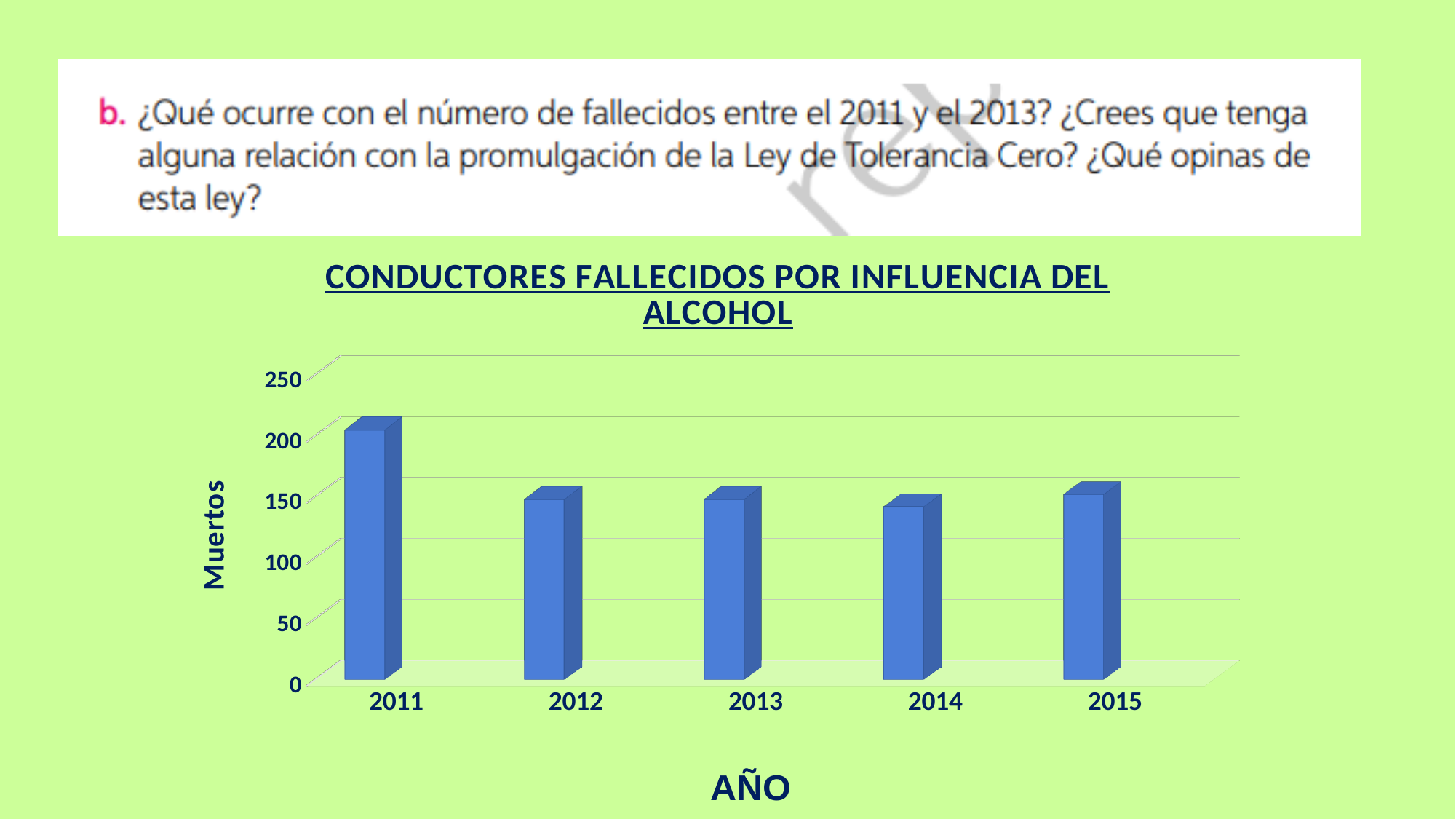
Is the value for 2011 greater or less than 150? greater Is the value for 2014 greater or less than 200? less What is the label of the vertical axis of the chart? Muertos Which year has the highest number of Muertos in the chart? 2011 Does the number of Muertos rise or fall from 2011 to 2012? fall Is the value for 2012 greater or less than 100? greater What kind of chart is shown on the slide? bar chart What is the highest tick value shown on the vertical axis? 250 Which is larger, the value for 2011 or the value for 2013? 2011 How many years are shown on the x axis of the chart? 5 What is the title of the chart? CONDUCTORES FALLECIDOS POR INFLUENCIA DEL ALCOHOL